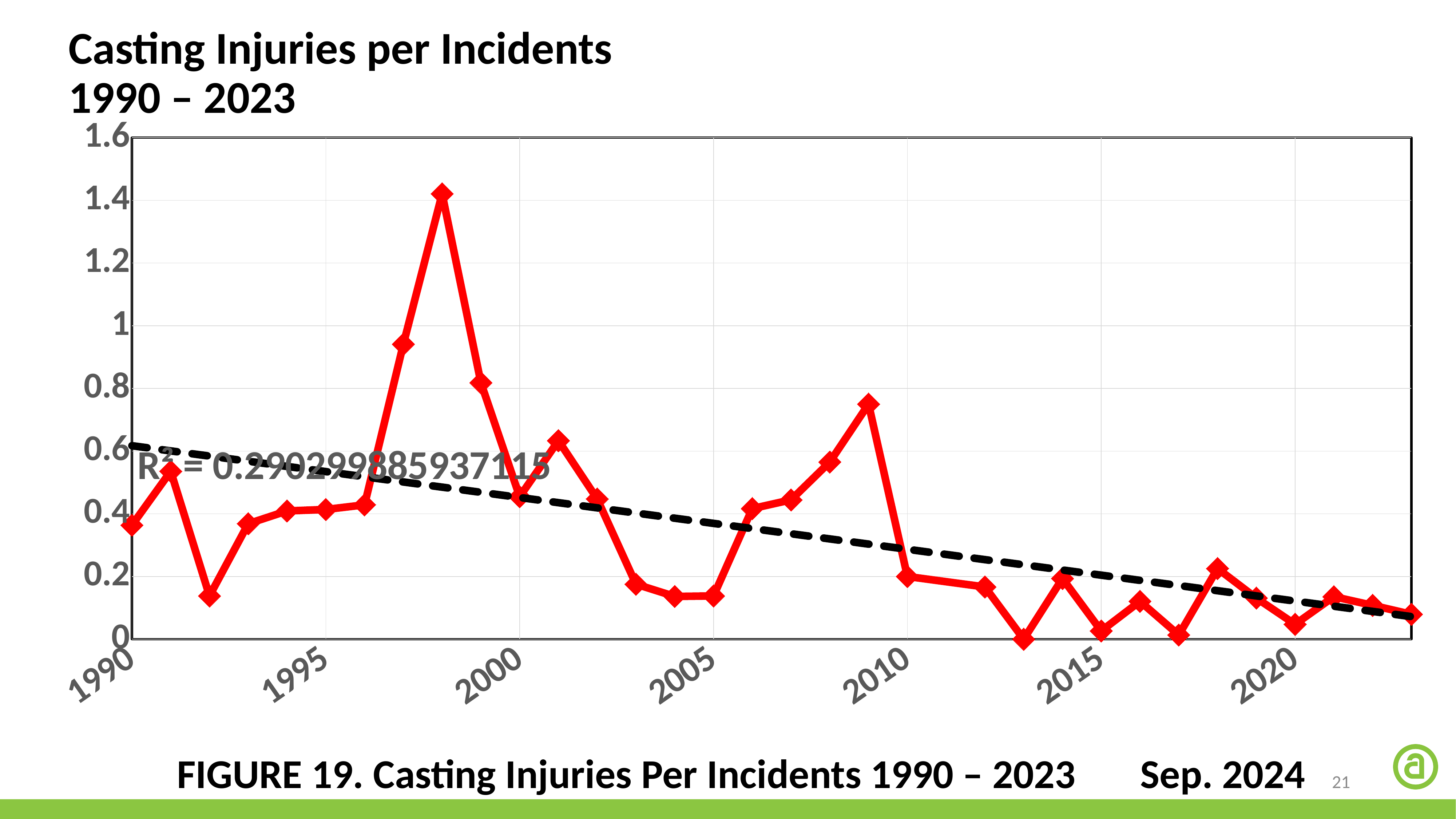
Is the value for 2009 greater or less than 0.6? greater What R² value is printed on the chart? R² = 0.290299885937115 Which year has the larger value, 1997 or 1999? 1997 According to the dashed trendline, do the values rise or fall from 1990 to 2023? Fall What kind of chart is shown on the slide? Line chart Is the value for 2010 greater or less than 0.4? less Is the value for 1992 greater or less than 0.2? less Which year has the highest casting injuries per incidents value? 1998 How many data points are plotted on the line? 33 Which year has the larger value, 1998 or 2009? 1998